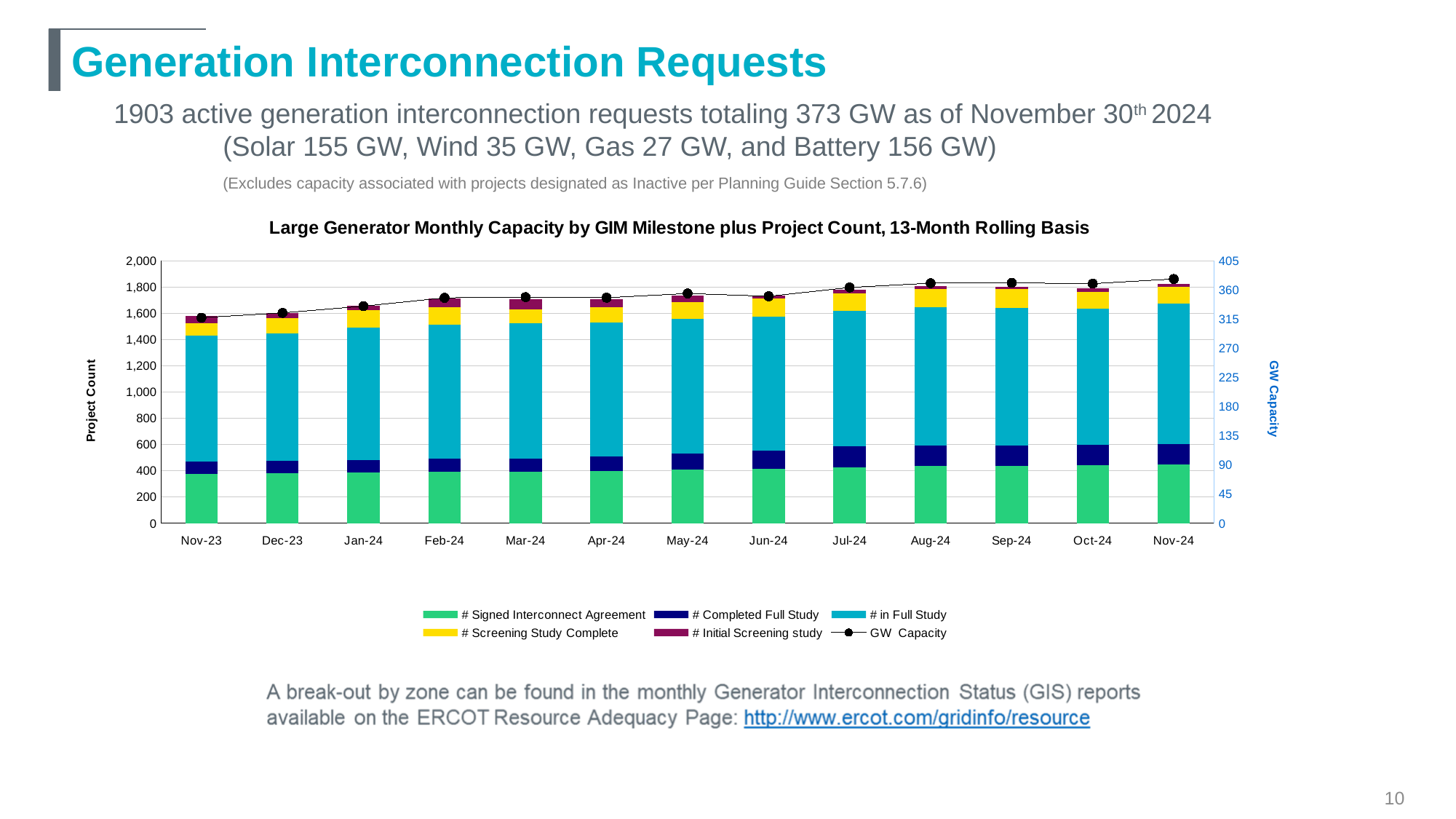
What type of chart is shown on the slide? Stacked bar chart with a line Does the GW Capacity line generally rise or fall from Nov-23 to Nov-24? Rise In Nov-24, which segment is larger: # in Full Study or # Signed Interconnect Agreement? # in Full Study Is the GW Capacity value for Nov-23 greater or less than 360? less Which month has the highest GW Capacity value? Nov-24 Is the # Signed Interconnect Agreement segment for Nov-24 greater or less than 600? less Which series is plotted as a line with markers rather than as bars? GW Capacity How many months are shown on the x axis of the chart? 13 What is the title of the chart? Large Generator Monthly Capacity by GIM Milestone plus Project Count, 13-Month Rolling Basis Is the total project count bar for Nov-24 greater or less than 1,600? greater Which month has the lowest GW Capacity value? Nov-23 How many series does the chart legend list? 6